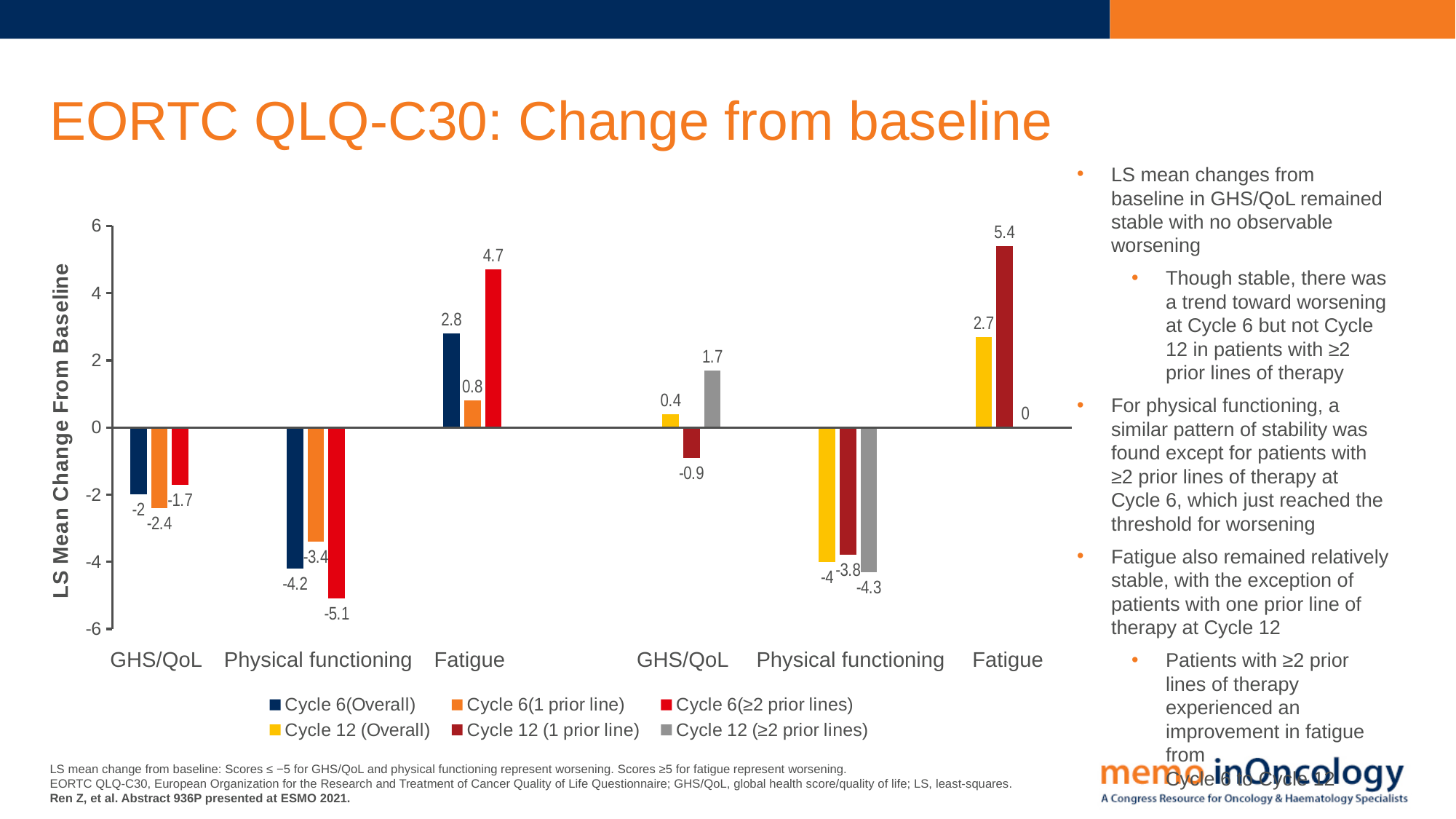
Which bar on the chart has the lowest value? Cycle 6 (≥2 prior lines), Physical functioning (-5.1) What is the label of the vertical axis? LS Mean Change From Baseline How many series does the legend list? 6 What kind of chart is shown on the slide? Bar chart What is the LS mean change from baseline in Physical functioning for Cycle 6 (Overall)? -4.2 Which bar on the chart has the highest value? Cycle 12 (1 prior line), Fatigue (5.4) What is the difference between the Fatigue values for Cycle 6 (≥2 prior lines) and Cycle 6 (1 prior line)? 3.9 What is the LS mean change from baseline in Fatigue for Cycle 6 (≥2 prior lines)? 4.7 Which is larger: the GHS/QoL value for Cycle 12 (≥2 prior lines) or for Cycle 12 (Overall)? Cycle 12 (≥2 prior lines) Is the Fatigue value for Cycle 12 (1 prior line) greater or less than 4? greater What is the LS mean change from baseline in GHS/QoL for Cycle 12 (1 prior line)? -0.9 What is the LS mean change from baseline in Fatigue for Cycle 12 (≥2 prior lines)? 0